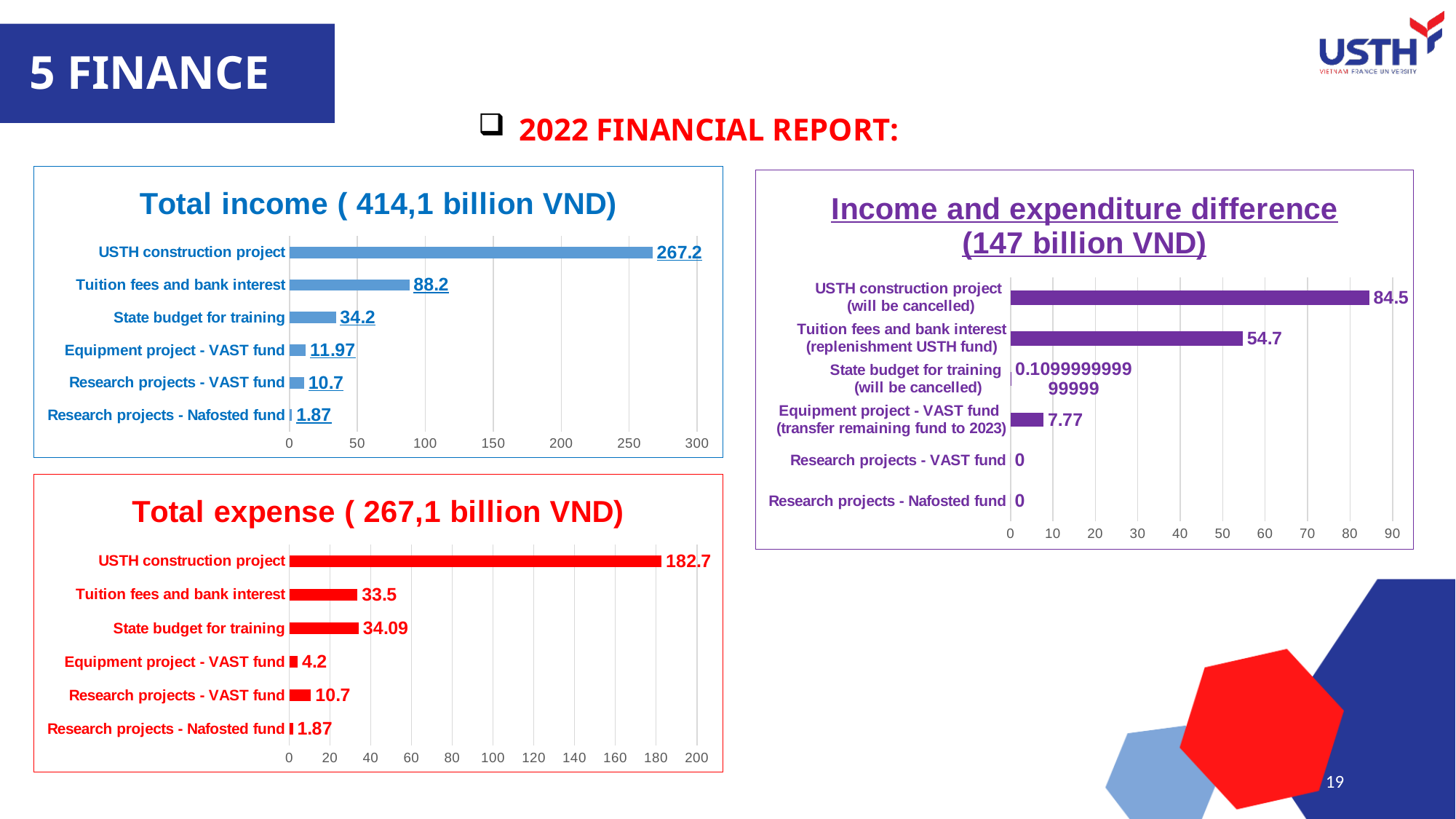
In the 'Income and expenditure difference' chart, what is the difference between USTH construction project and Tuition fees and bank interest? 29.8 In the 'Total income' chart, what is the value for USTH construction project? 267.2 How many categories are shown in the 'Total expense' chart? 6 In the 'Total expense' chart, what is the value for Tuition fees and bank interest? 33.5 In the 'Income and expenditure difference' chart, what is the value for Equipment project - VAST fund (transfer remaining fund to 2023)? 7.77 What type of chart is the 'Income and expenditure difference' chart? Bar chart In the 'Total income' chart, what is the value for Equipment project - VAST fund? 11.97 In the 'Total expense' chart, which is larger: Research projects - VAST fund or Equipment project - VAST fund? Research projects - VAST fund In the 'Total income' chart, which category has the lowest value? Research projects - Nafosted fund In the 'Income and expenditure difference' chart, what is the value for Tuition fees and bank interest (replenishment USTH fund)? 54.7 In the 'Total expense' chart, which category has the highest value? USTH construction project In the 'Total income' chart, what is the difference between Tuition fees and bank interest and State budget for training? 54